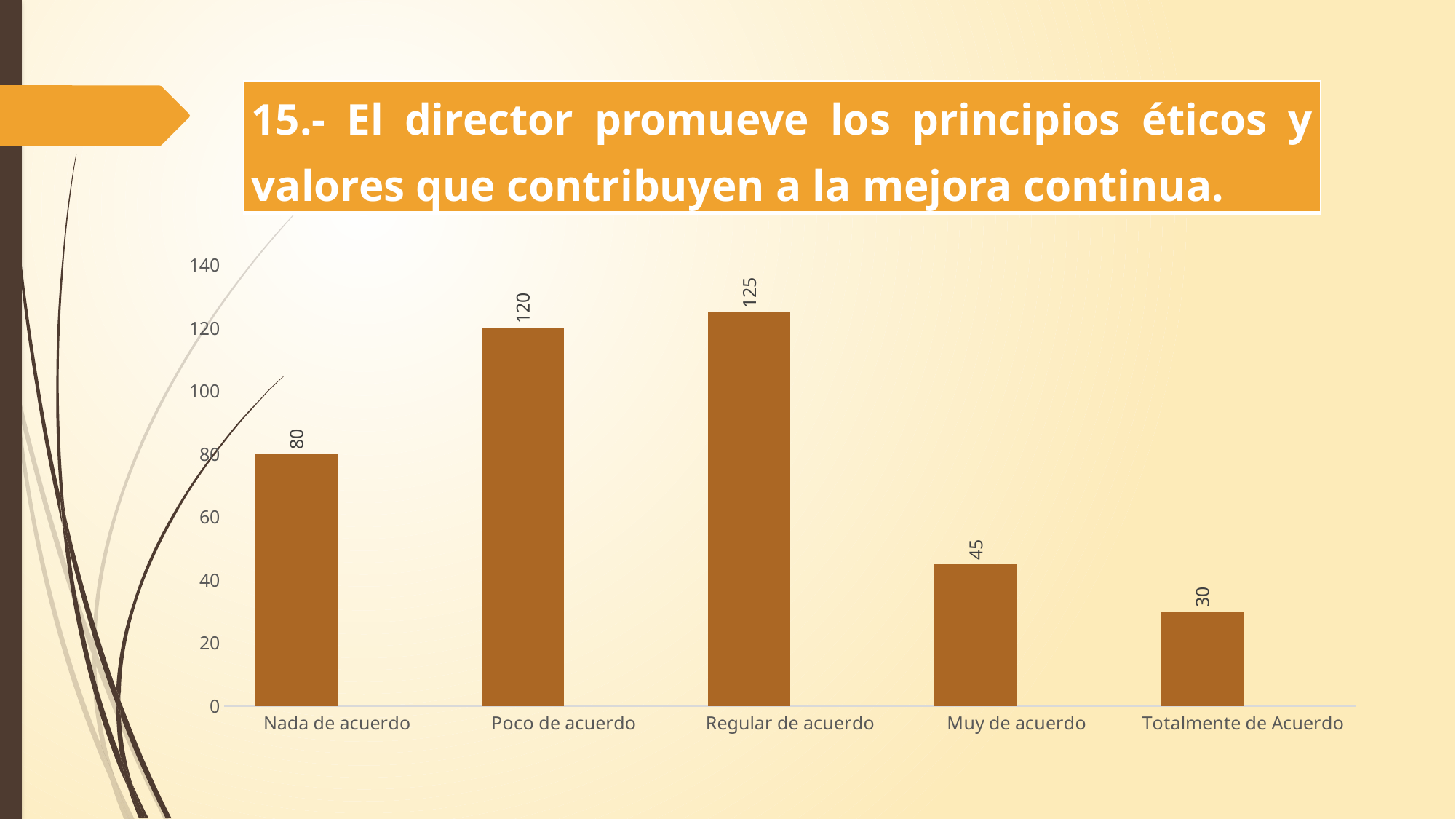
What kind of chart is shown on the slide? Bar chart What is the difference between the values for Regular de acuerdo and Poco de acuerdo? 5 What is the value for Muy de acuerdo? 45 What is the value for Totalmente de Acuerdo? 30 Which category has the lowest value? Totalmente de Acuerdo What is the value for Regular de acuerdo? 125 Which is larger, the value for Nada de acuerdo or the value for Muy de acuerdo? Nada de acuerdo Which category has the highest value? Regular de acuerdo What is the value for Poco de acuerdo? 120 How many categories are shown on the x axis? 5 What is the value for Nada de acuerdo? 80 What is the difference between the values for Nada de acuerdo and Muy de acuerdo? 35